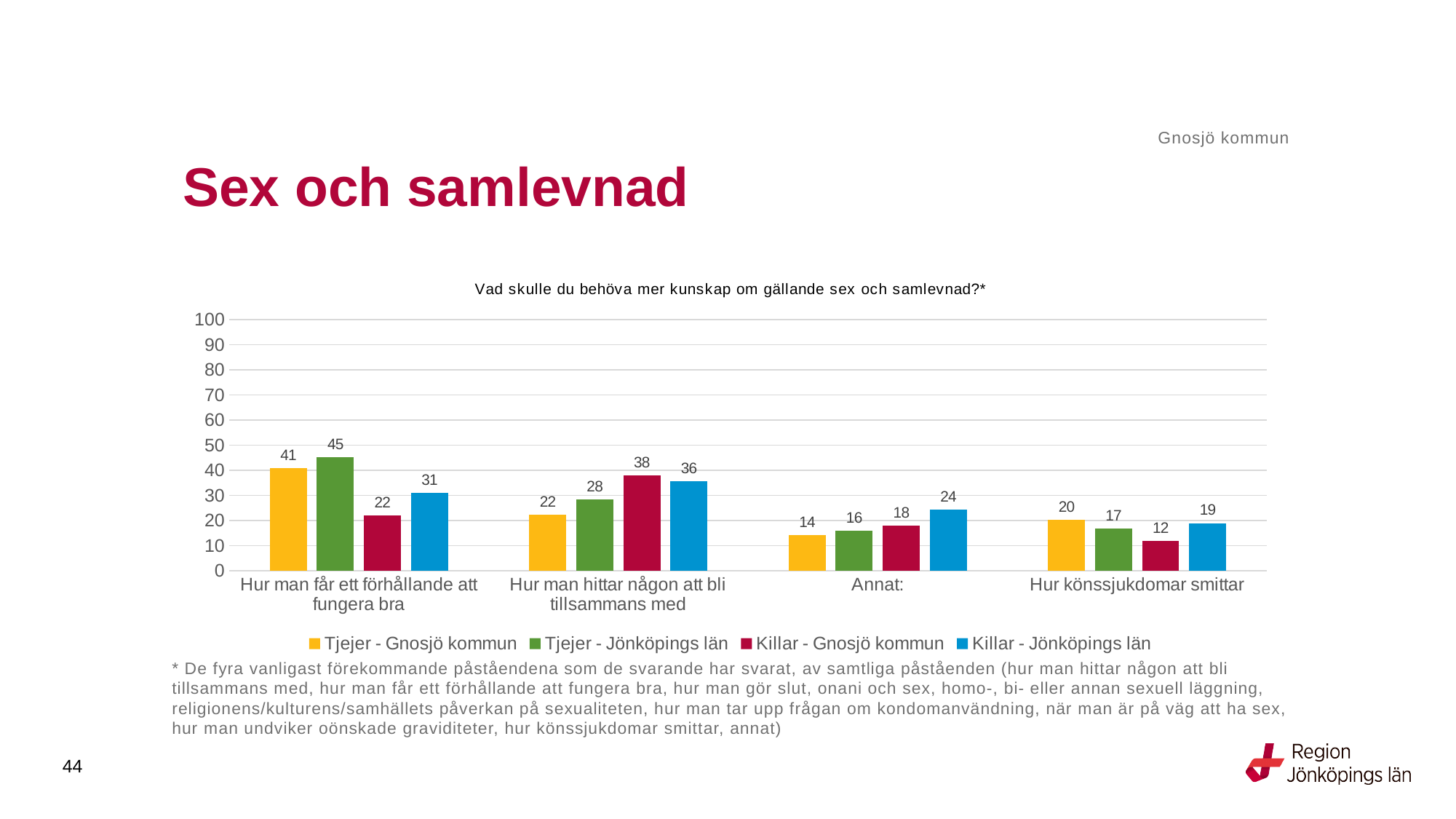
How many categories are shown on the x axis of the chart? 4 What is the value for Killar - Gnosjö kommun in the category 'Hur man hittar någon att bli tillsammans med'? 38 Is the value for Tjejer - Jönköpings län in the category 'Hur man hittar någon att bli tillsammans med' greater or less than 30? less Which series has the highest value in the category 'Hur man får ett förhållande att fungera bra'? Tjejer - Jönköpings län What is the value for Tjejer - Gnosjö kommun in the category 'Hur man får ett förhållande att fungera bra'? 41 What is the difference between Tjejer - Jönköpings län and Killar - Gnosjö kommun in the category 'Hur man får ett förhållande att fungera bra'? 23 Which series has the lowest value in the category 'Hur könssjukdomar smittar'? Killar - Gnosjö kommun What is the title of the chart? Vad skulle du behöva mer kunskap om gällande sex och samlevnad?* Which is larger in the category 'Hur man hittar någon att bli tillsammans med': Tjejer - Gnosjö kommun or Killar - Jönköpings län? Killar - Jönköpings län How many series does the legend list? 4 What kind of chart is shown on the slide? Bar chart What is the value for Killar - Jönköpings län in the category 'Annat:'? 24